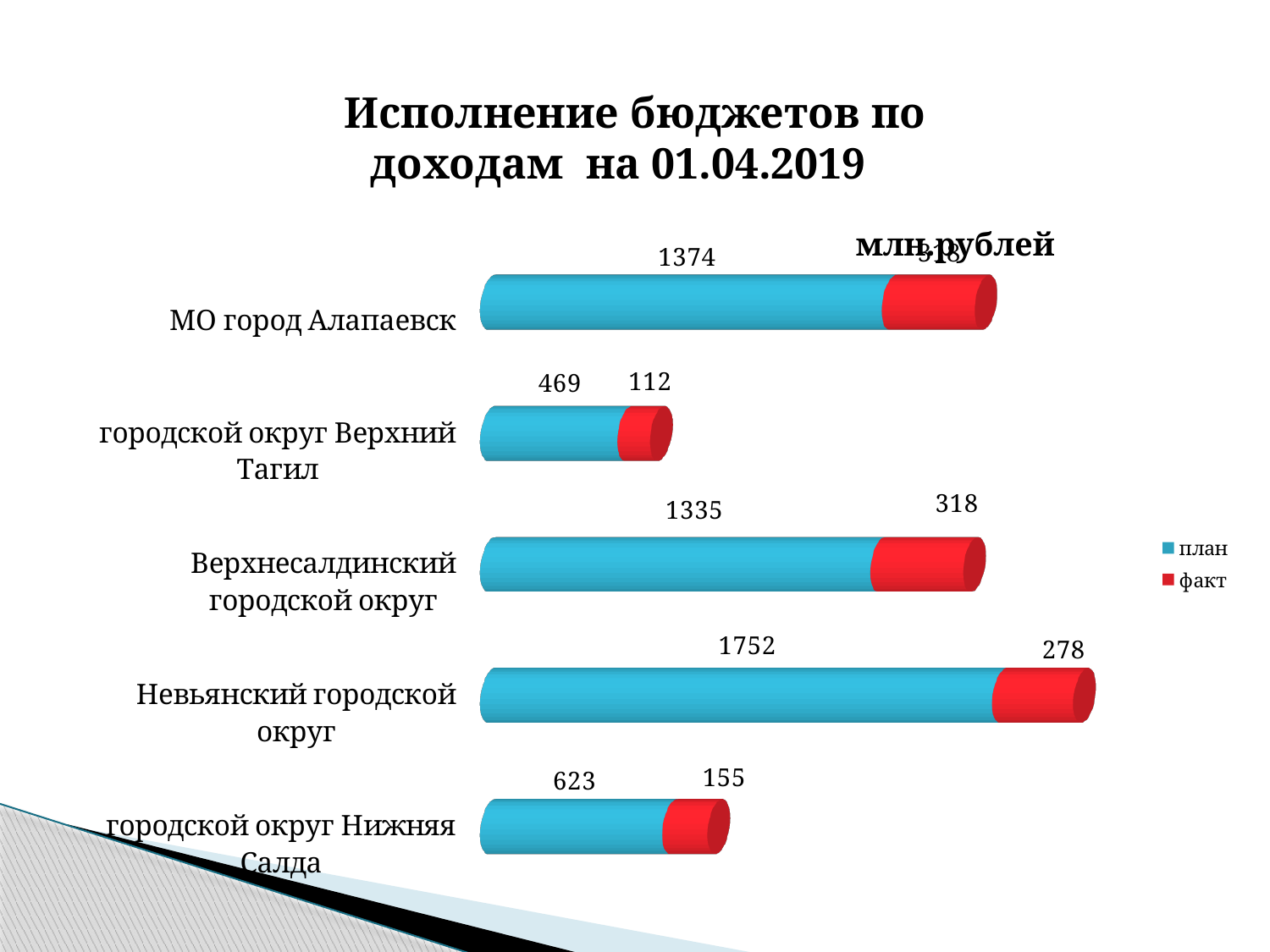
What is the total of the stacked bar for Невьянский городской округ (план plus факт)? 2030 Which category has the highest план value? Невьянский городской округ What is the план value for городской округ Нижняя Салда? 623 What is the факт value for городской округ Верхний Тагил? 112 What is the факт value for Верхнесалдинский городской округ? 318 Which category has the lowest план value? городской округ Верхний Тагил What is the план value for Невьянский городской округ? 1752 What kind of chart is shown on the slide? bar chart Which has the larger план value: МО город Алапаевск or Верхнесалдинский городской округ? МО город Алапаевск What is the difference between the план and факт values for городской округ Нижняя Салда? 468 How many categories are shown in the chart? 5 How many series does the legend list? 2